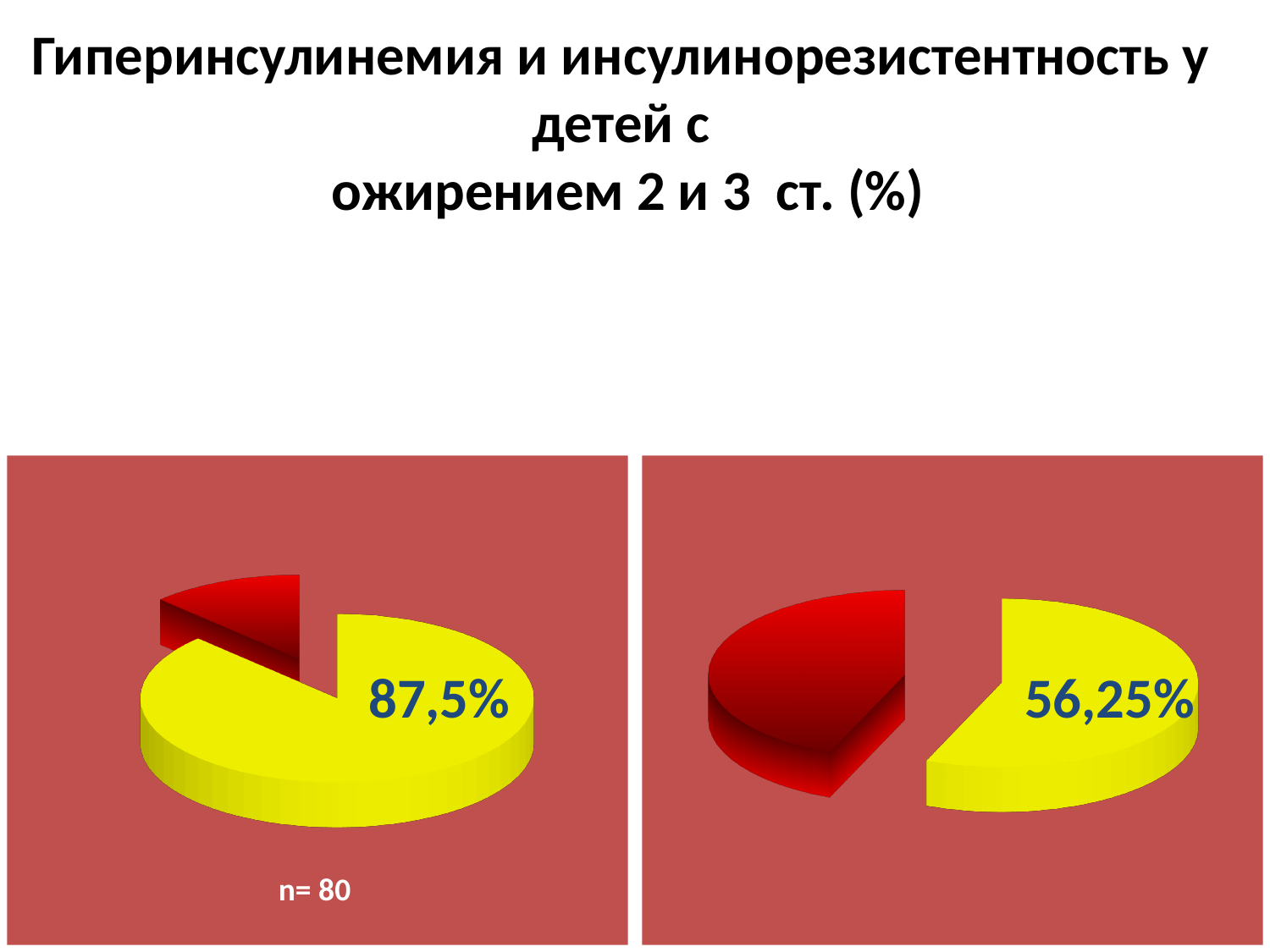
In the right pie chart, which slice is larger, the yellow one or the red one? the yellow one What colour is the slice that carries the printed percentage label in both pie charts? yellow How many slices does the left pie chart have? 2 In the left pie chart, which slice is larger, the yellow one or the red one? the yellow one What kind of chart is shown on the right side of the slide? pie chart Which is larger: the labelled yellow slice in the left pie chart or the labelled yellow slice in the right pie chart? the left pie chart (87,5%) How many slices does the right pie chart have? 2 What kind of chart is shown on the left side of the slide? pie chart In the left pie chart, what value is printed on the yellow slice? 87,5% In the right pie chart, what value is printed on the yellow slice? 56,25% What is the difference between the labelled value in the left pie chart (87,5%) and the labelled value in the right pie chart (56,25%)? 31,25% What sample size (n) is printed below the left pie chart? n= 80